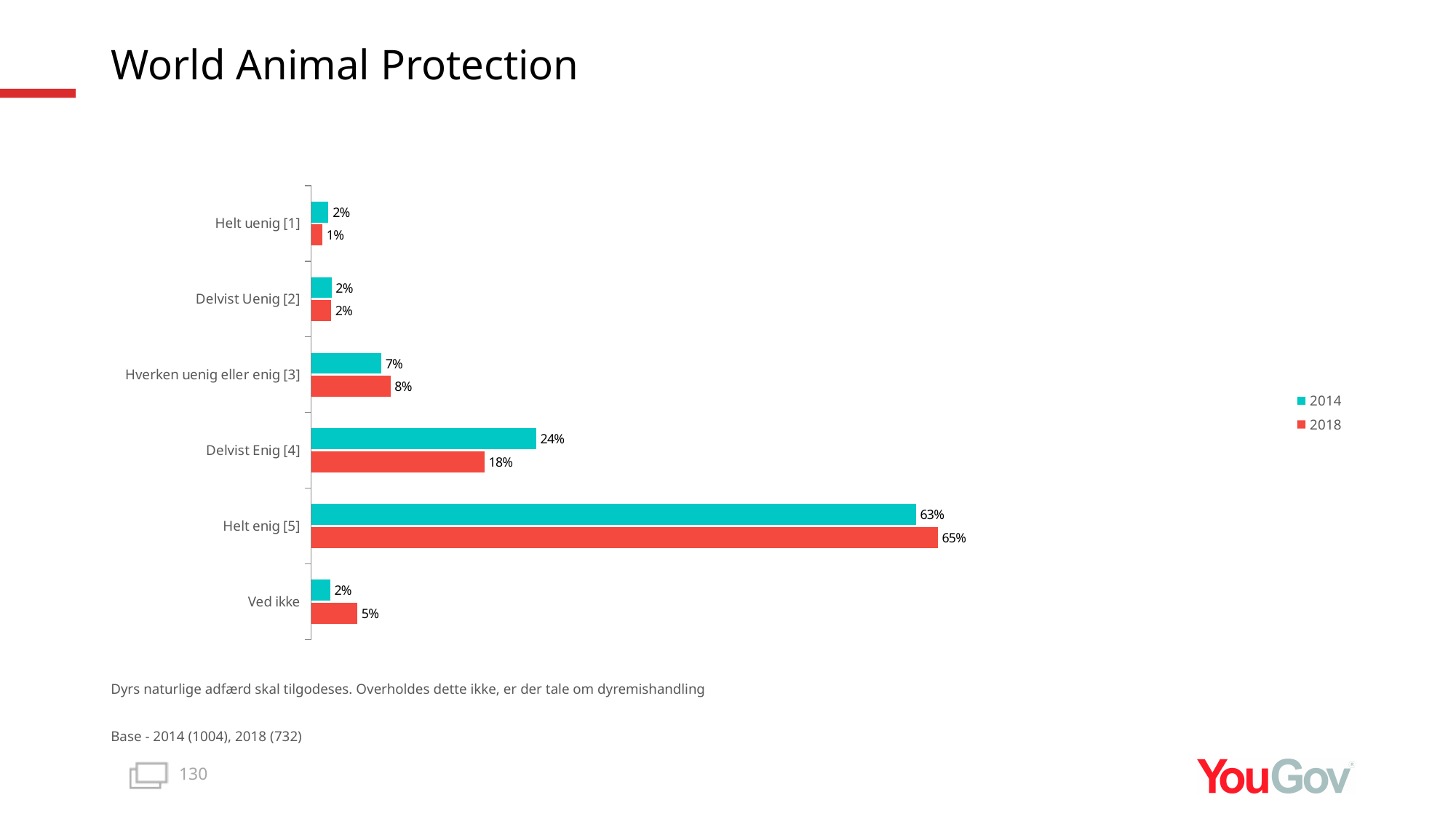
Which colour represents the 2018 series? Red What is the 2018 value for Ved ikke? 5% What is the 2014 value for Delvist Enig [4]? 24% Which category has the highest 2018 value? Helt enig [5] What kind of chart is shown on the slide? Bar chart What is the 2018 value for Helt enig [5]? 65% How many series does the legend list? 2 What is the difference between the 2014 and 2018 values for Delvist Enig [4]? 6% For Ved ikke, which year has the larger value, 2014 or 2018? 2018 How many categories are shown on the chart? 6 Which category has the lowest 2018 value? Helt uenig [1] What is the 2014 value for Hverken uenig eller enig [3]? 7%